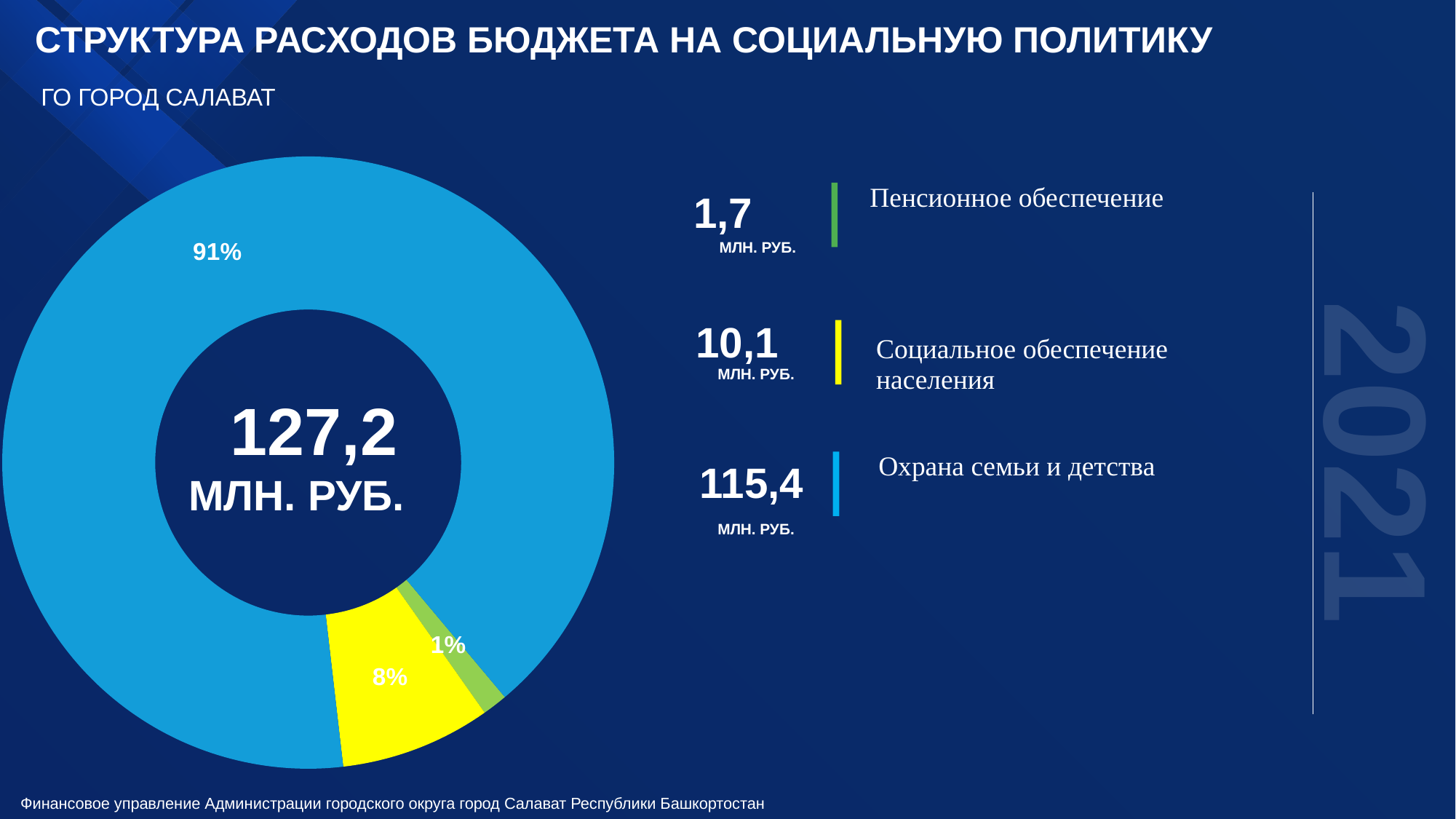
Which category has the largest share of the pie? Охрана семьи и детства What type of chart is shown on the slide? Pie chart (donut) What share of the pie does the slice for Социальное обеспечение населения represent? 8% How many slices does the pie chart have? 3 What is the value shown for Социальное обеспечение населения? 10,1 млн. руб. What is the value shown for Охрана семьи и детства? 115,4 млн. руб. What total value is shown in the centre of the donut chart? 127,2 млн. руб. Which category has the smallest share of the pie? Пенсионное обеспечение What is the value shown for Пенсионное обеспечение? 1,7 млн. руб. What is the difference between the values for Охрана семьи и детства and Социальное обеспечение населения? 105,3 млн. руб. What share of the pie does the slice for Охрана семьи и детства represent? 91% What share of the pie does the slice for Пенсионное обеспечение represent? 1%